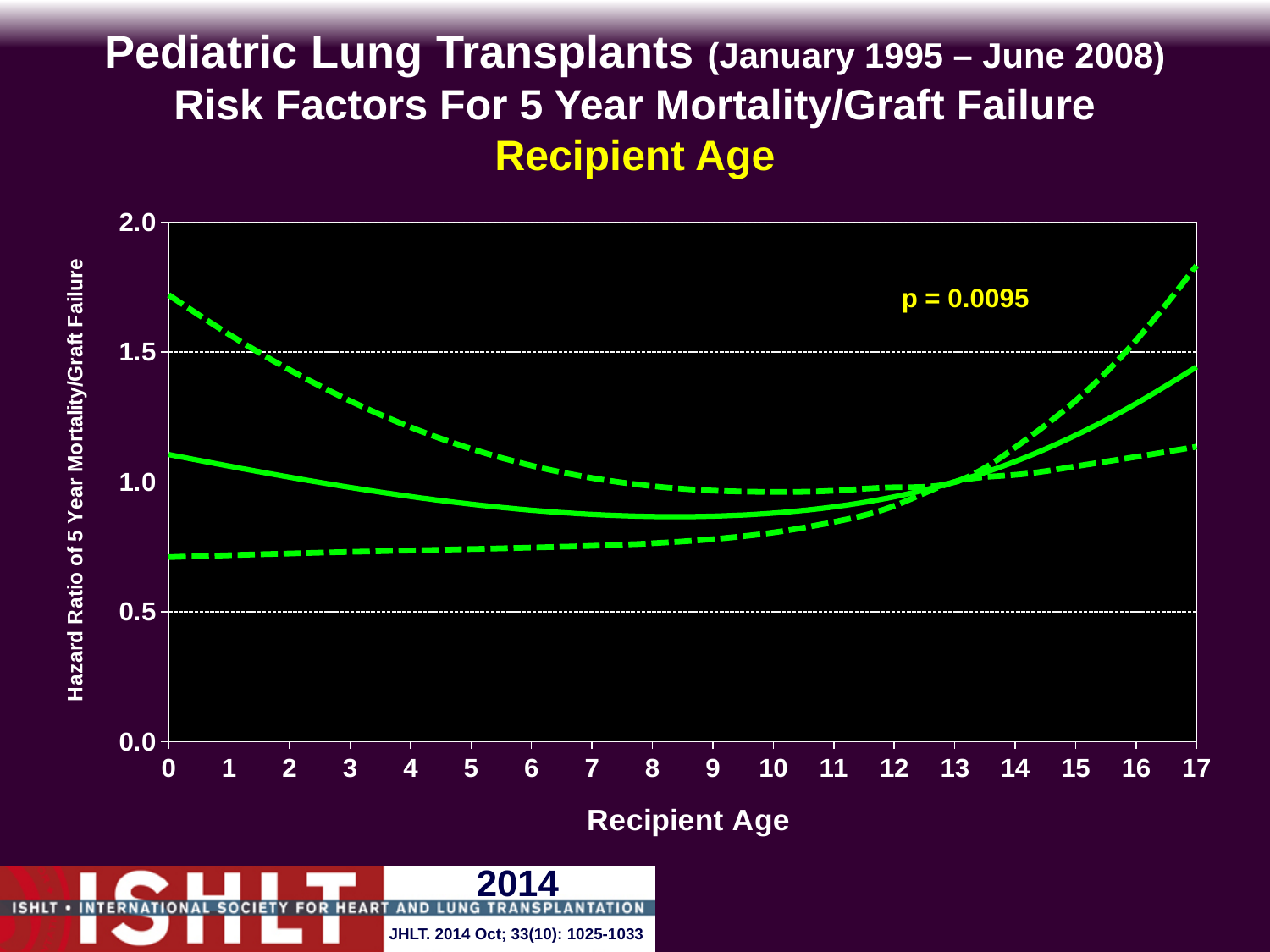
What p-value is printed on the chart? p = 0.0095 Is the value of the upper dashed line at recipient age 0 greater or less than 1.5? greater Is the value of the solid line at recipient age 0 greater or less than 1.0? greater Is the value of the solid line at recipient age 8 greater or less than 1.0? less How many lines are plotted on the chart? 3 What is the title of the y axis of the chart? Hazard Ratio of 5 Year Mortality/Graft Failure How many age values are labelled on the x axis? 18 Does the solid line rise or fall between recipient age 13 and recipient age 17? rise Which is larger for the solid line: the value at recipient age 0 or at recipient age 17? recipient age 17 What kind of chart is shown on the slide? line chart